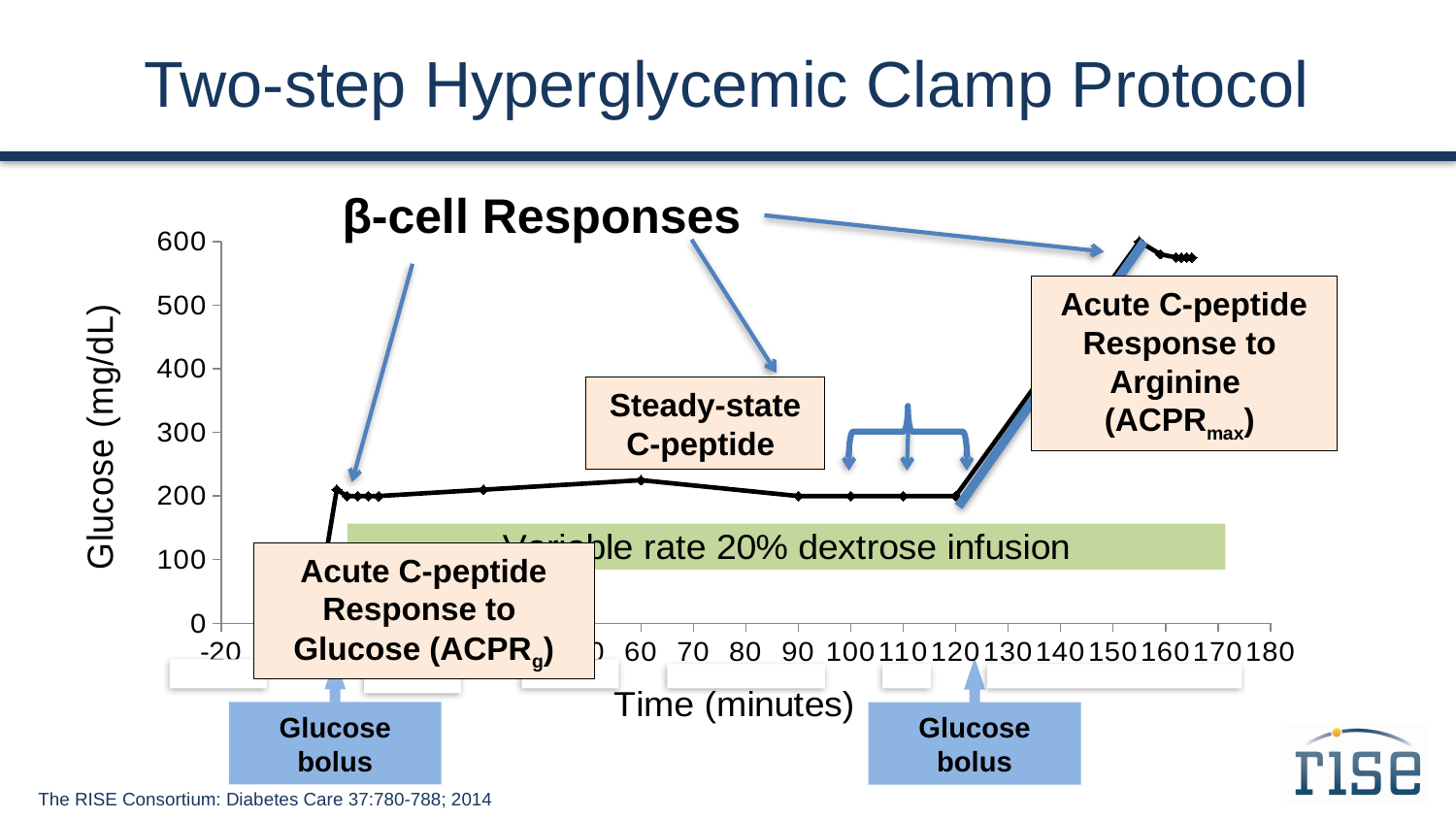
Is the glucose value at 60 minutes greater or less than 300? less Which time point has the higher glucose value, 60 minutes or 160 minutes? 160 minutes Does the glucose value rise or fall between 120 and 150 minutes? rise What is the label of the y-axis of the chart? Glucose (mg/dL) Is the glucose value at 160 minutes greater or less than 500? greater What is the label of the x-axis of the chart? Time (minutes) Is the glucose value at 90 minutes greater or less than 100? greater What kind of chart is shown on the slide? line chart What is the highest value shown on the y-axis of the chart? 600